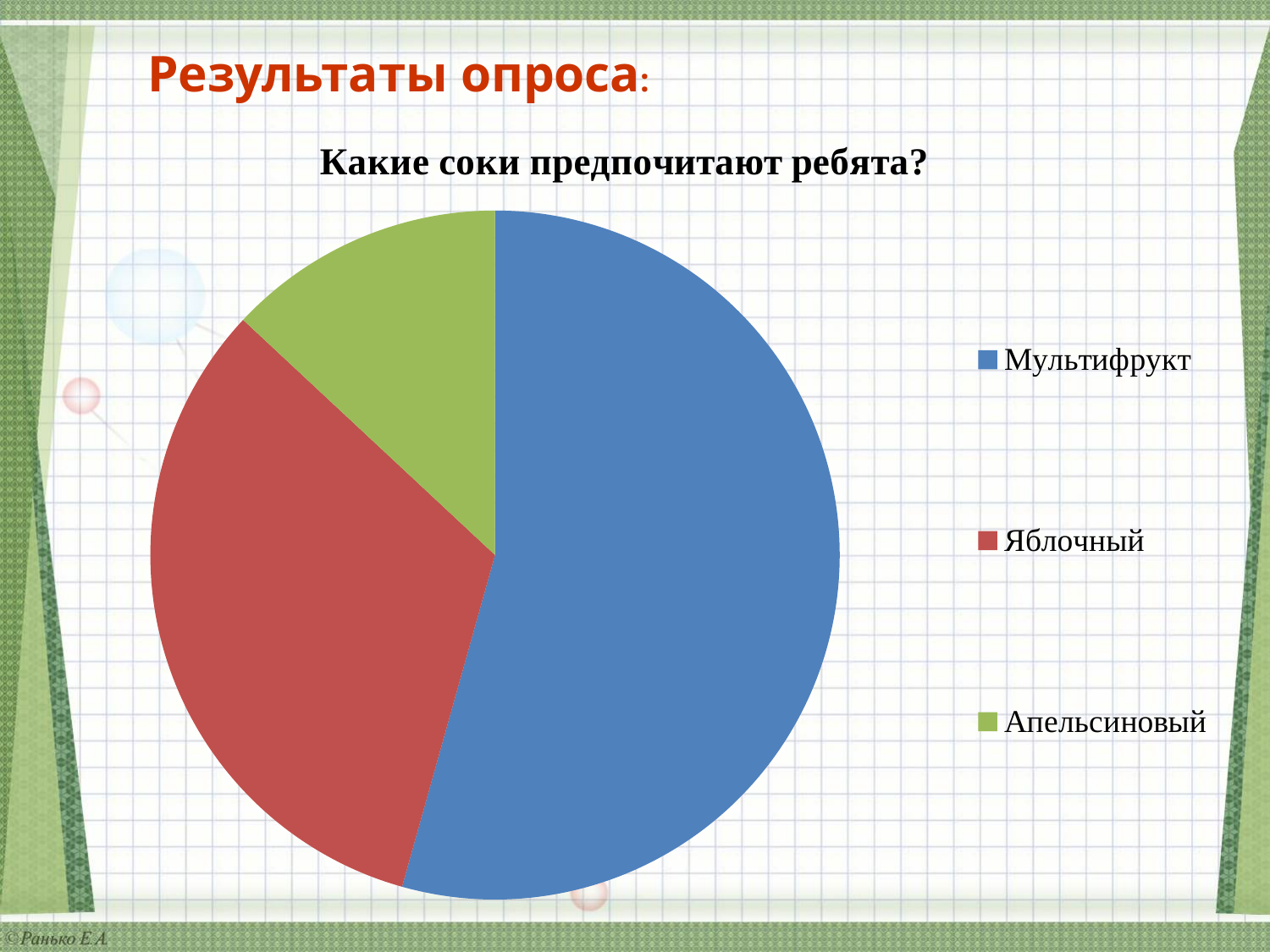
Which juice has the smallest slice of the pie? Апельсиновый Which colour represents Яблочный in the pie chart? red What kind of chart is shown on the slide? pie chart Does the Мультифрукт slice take up more or less than half of the pie? more Which slice is larger, Мультифрукт or Яблочный? Мультифрукт What is the title of the chart? Какие соки предпочитают ребята? How many categories (slices) does the pie chart have? 3 Which slice is larger, Яблочный or Апельсиновый? Яблочный Which juice has the largest slice of the pie? Мультифрукт